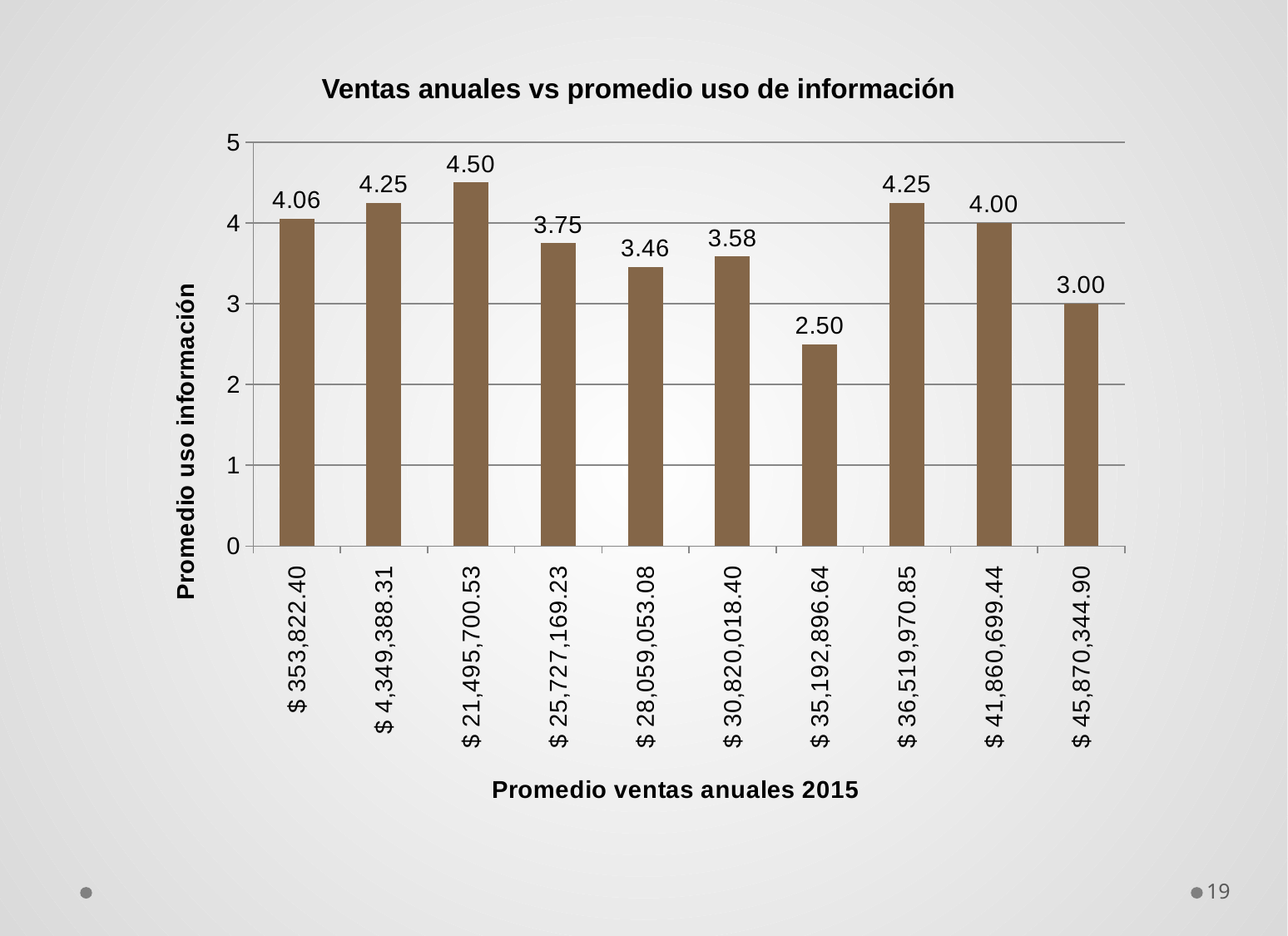
What is the value for $ 353,822.40? 4.06 How many bars are shown in the chart? 10 Which category has the highest value? $ 21,495,700.53 Which category has the lowest value? $ 35,192,896.64 Which is larger, the value for $ 28,059,053.08 or the value for $ 30,820,018.40? $ 30,820,018.40 What kind of chart is shown on the slide? bar chart What is the value for $ 45,870,344.90? 3.00 What is the difference between the values for $ 21,495,700.53 and $ 35,192,896.64? 2.00 What is the value for $ 21,495,700.53? 4.50 Is the value for $ 25,727,169.23 greater or less than 4? less What is the title of the chart? Ventas anuales vs promedio uso de información What is the value for $ 35,192,896.64? 2.50